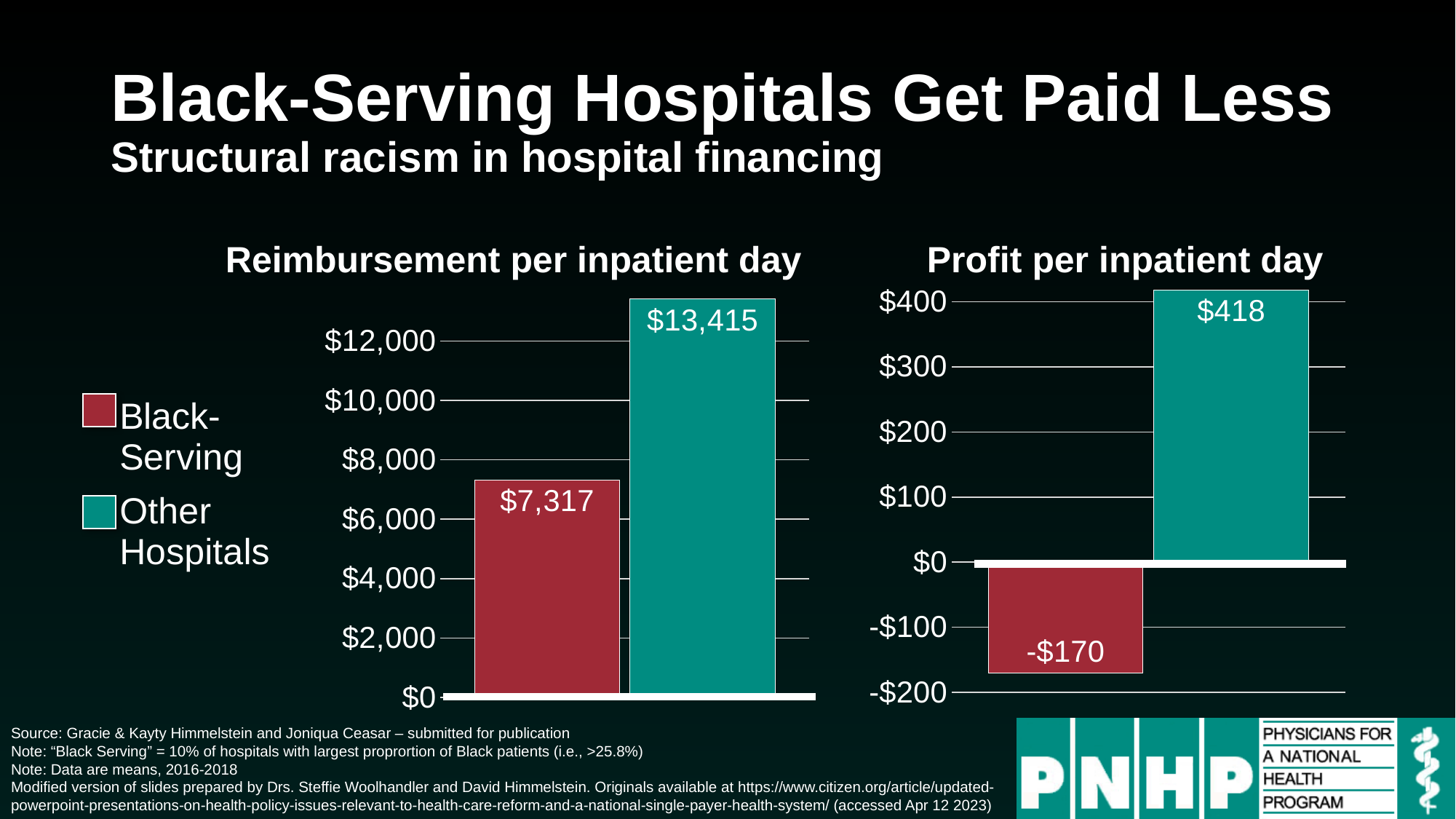
In the 'Profit per inpatient day' chart, what is the difference between Other Hospitals and Black-Serving hospitals? $588 What kind of chart is the 'Profit per inpatient day' chart? bar chart In the 'Profit per inpatient day' chart, what is the value for Black-Serving hospitals? -$170 In the 'Reimbursement per inpatient day' chart, what is the value for Other Hospitals? $13,415 In the 'Reimbursement per inpatient day' chart, what is the value for Black-Serving hospitals? $7,317 What colour represents Other Hospitals in the legend? teal How many series does the legend list? 2 In the 'Reimbursement per inpatient day' chart, which group has the higher reimbursement? Other Hospitals In the 'Profit per inpatient day' chart, what is the value for Other Hospitals? $418 In the 'Reimbursement per inpatient day' chart, is the value for Black-Serving hospitals greater or less than $8,000? less In the 'Profit per inpatient day' chart, which group has the lowest profit? Black-Serving In the 'Reimbursement per inpatient day' chart, what is the difference between Other Hospitals and Black-Serving hospitals? $6,098